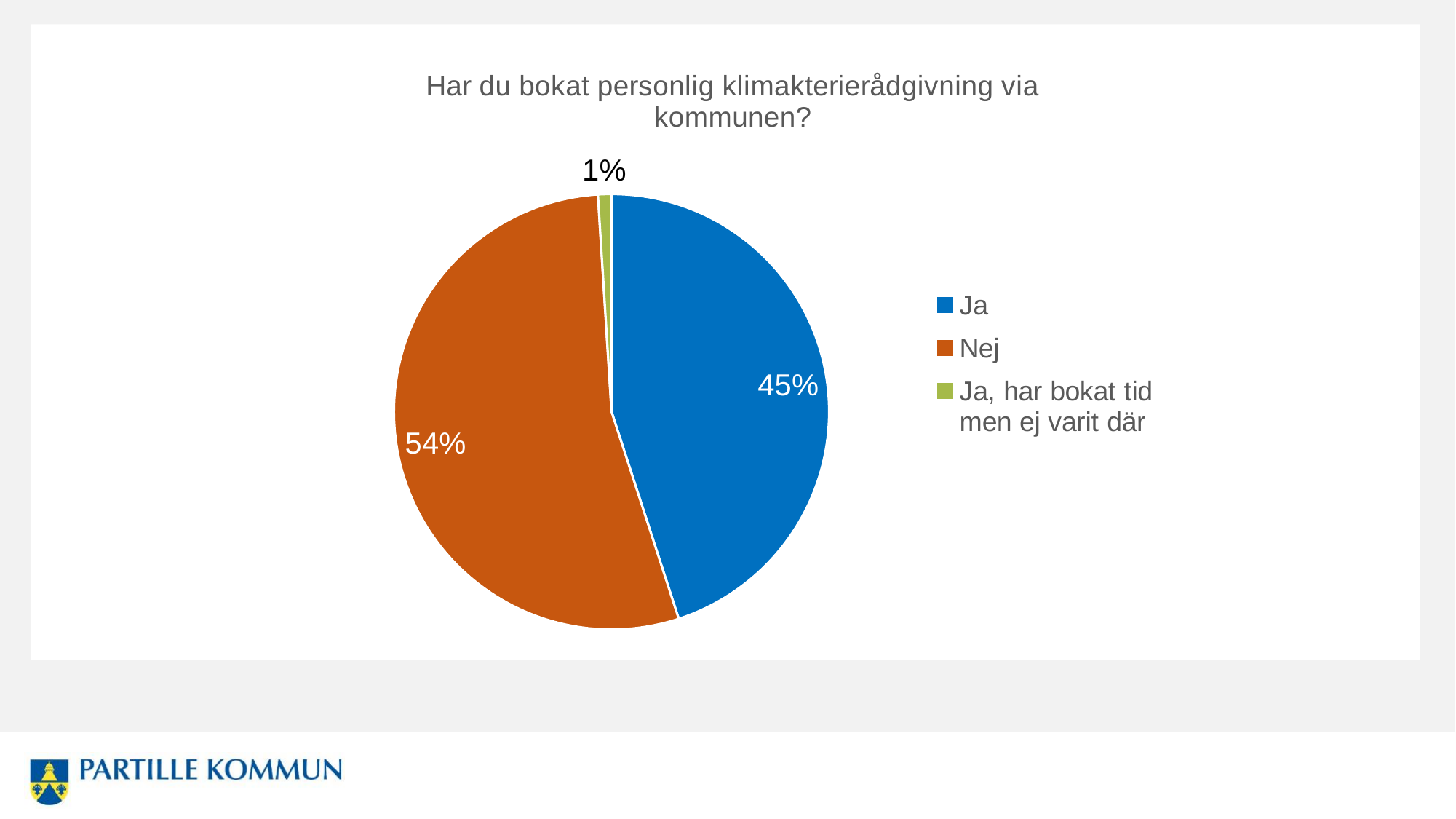
Which slice is larger, "Ja" or "Nej"? Nej What share of the pie does "Ja" represent? 45% What is the difference in percentage points between the "Nej" and "Ja" slices? 9 What share of the pie does "Ja, har bokat tid men ej varit där" represent? 1% What is the title of the chart? Har du bokat personlig klimakterierådgivning via kommunen? Which category has the smallest slice of the pie? Ja, har bokat tid men ej varit där What kind of chart is shown on the slide? Pie chart Which category has the largest slice of the pie? Nej How many categories are shown in the pie chart? 3 What share of the pie does "Nej" represent? 54% What colour is the "Nej" slice? Orange Is the share for "Ja" greater or less than 50%? less